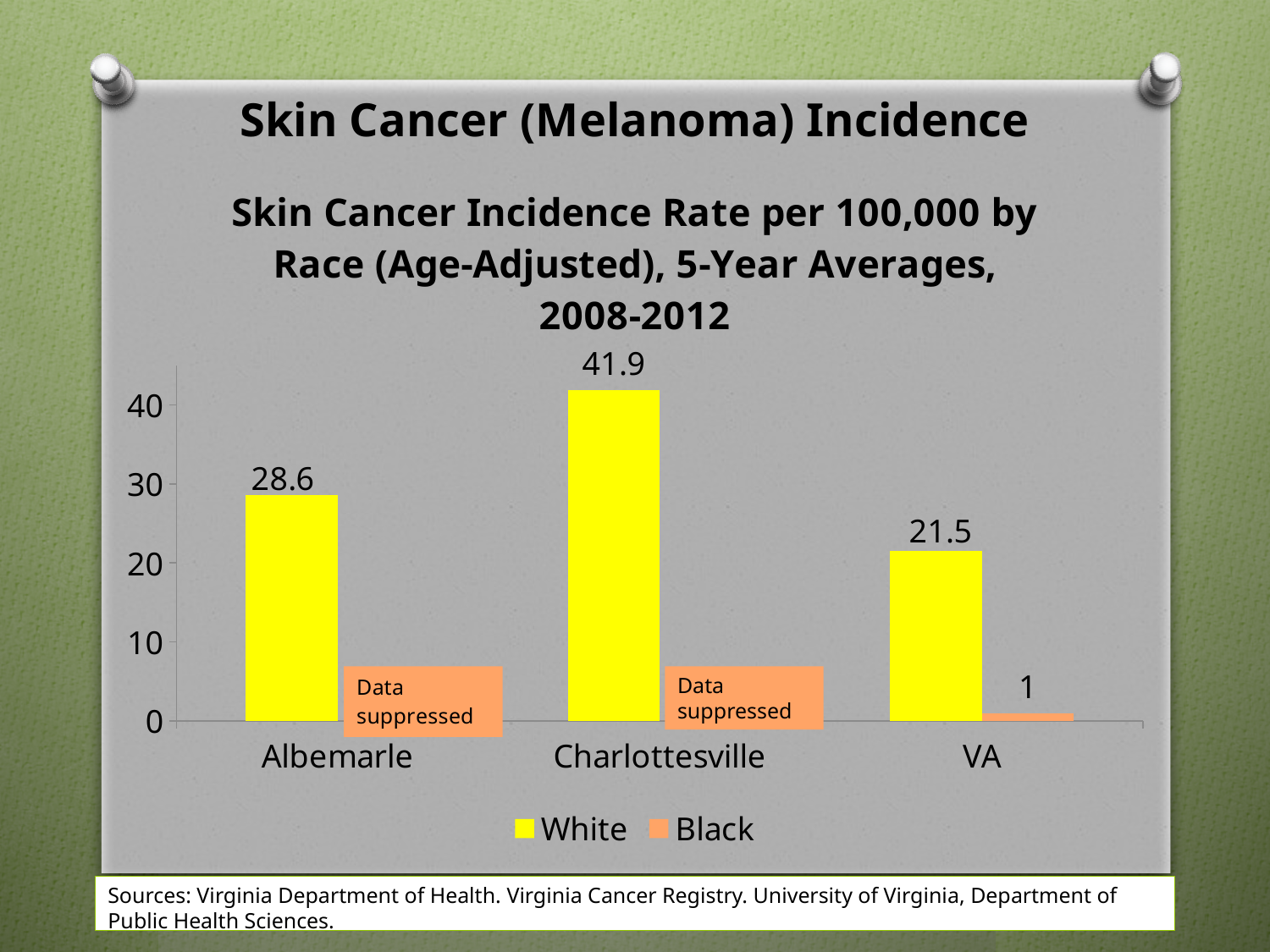
What is the difference between the White incidence rates in Charlottesville and Albemarle? 13.3 What kind of chart is shown on the slide? Bar chart How many localities are shown on the x axis? 3 What is the skin cancer incidence rate for Black residents in VA? 1 What is the skin cancer incidence rate for White residents in VA? 21.5 What is the skin cancer incidence rate for White residents in Albemarle? 28.6 What is shown in place of the Black incidence rate for Albemarle and Charlottesville? Data suppressed Which locality has the lowest skin cancer incidence rate for White residents? VA How many series does the legend list? 2 Which locality has the highest skin cancer incidence rate for White residents? Charlottesville Which is larger, the White incidence rate in Albemarle or in VA? Albemarle What is the skin cancer incidence rate for White residents in Charlottesville? 41.9